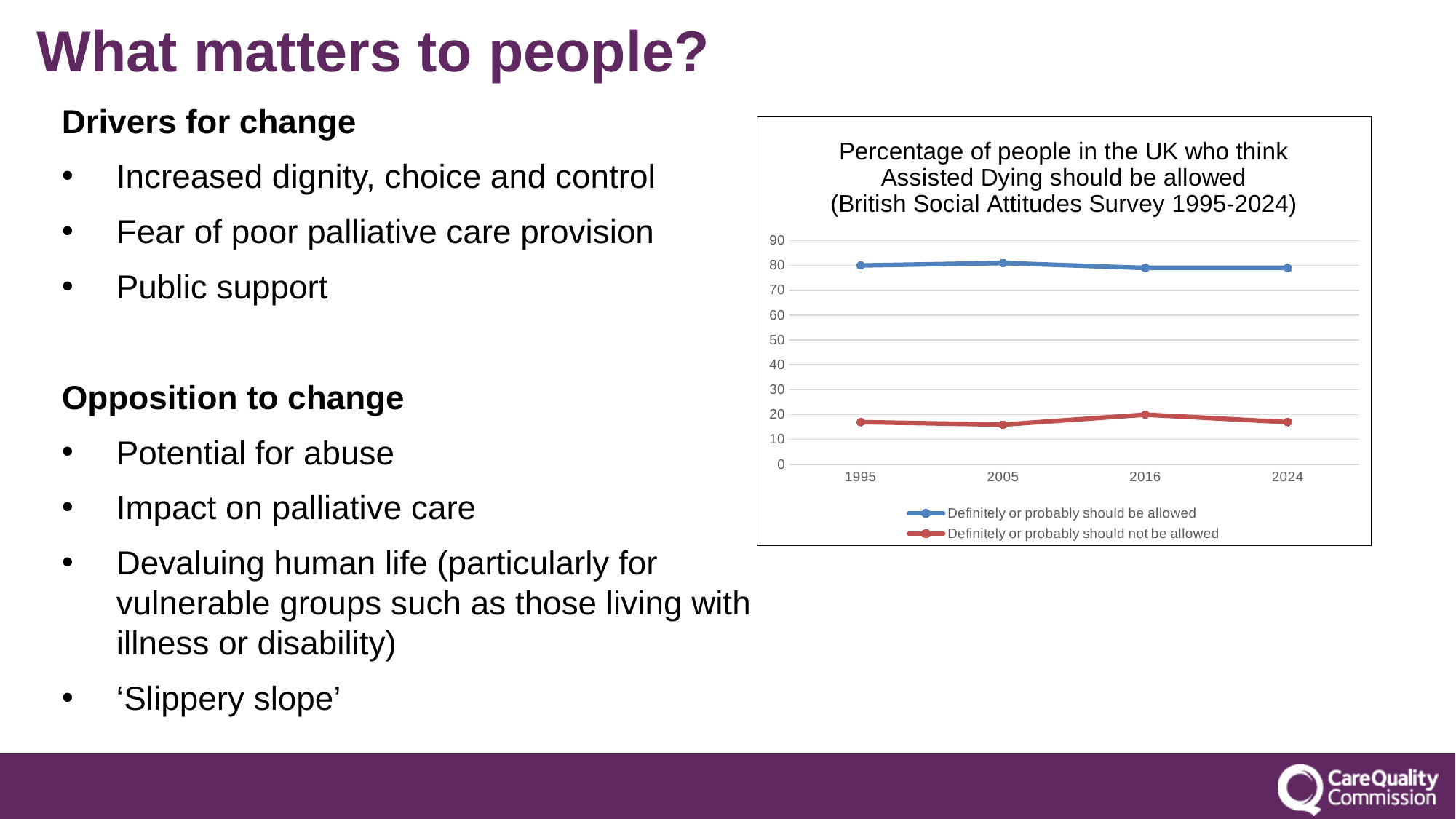
What is the first year shown on the x axis of the chart? 1995 In which year does the 'Definitely or probably should not be allowed' series reach its highest value? 2016 Is the value for 'Definitely or probably should be allowed' in 1995 greater or less than 70? greater How many series does the chart's legend list? 2 Is the value for 'Definitely or probably should not be allowed' in 1995 greater or less than 10? greater Which survey is named in the chart title as the source of the data? British Social Attitudes Survey 1995-2024 Is the value for 'Definitely or probably should not be allowed' in 2005 greater or less than 20? less How many years are plotted along the x axis of the chart? 4 What kind of chart is shown on the slide? line chart In 2016, which series has the larger value: 'Definitely or probably should be allowed' or 'Definitely or probably should not be allowed'? Definitely or probably should be allowed